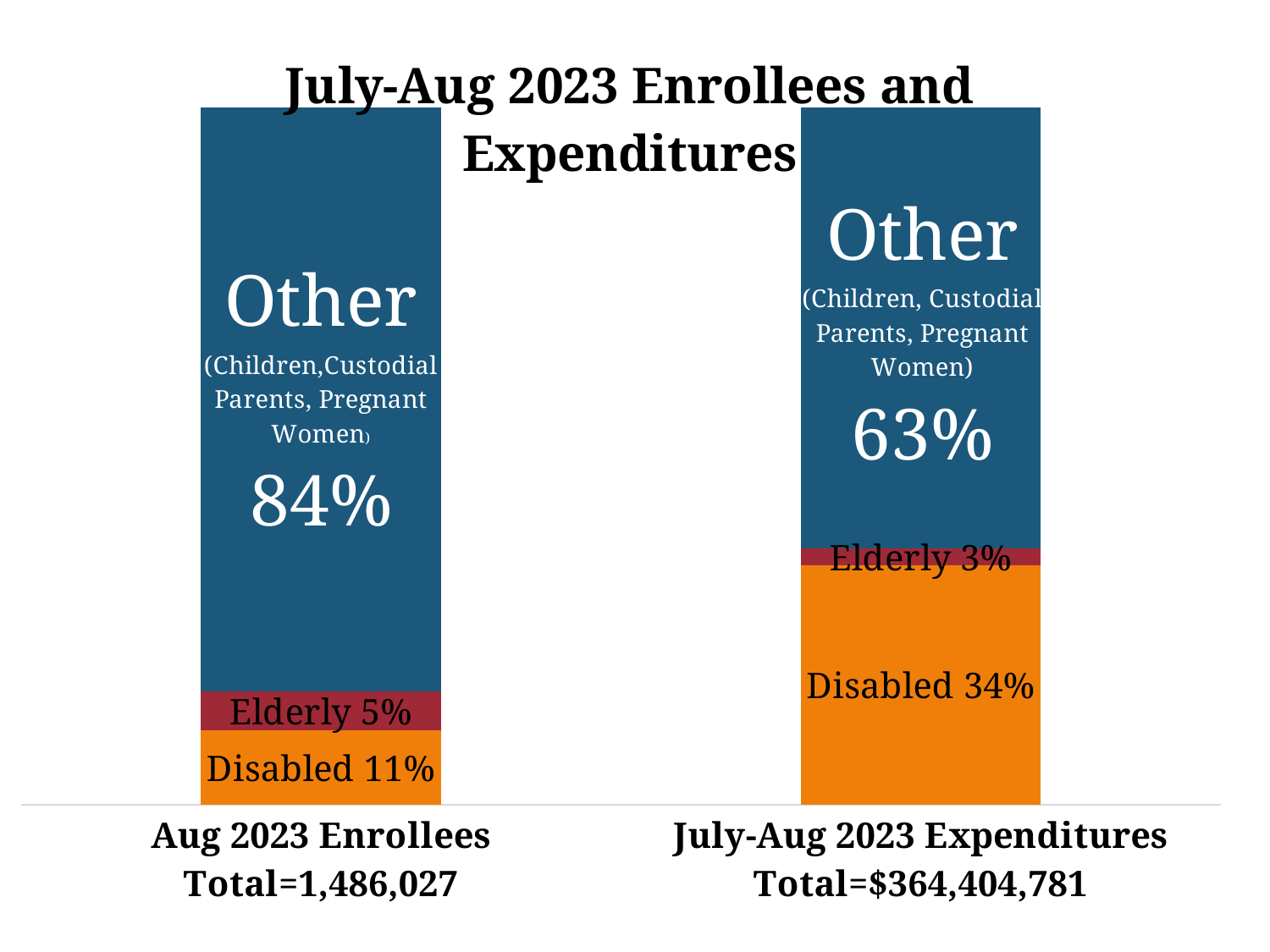
What kind of chart is shown on the slide? Stacked bar chart What is the difference between the Disabled share of July-Aug 2023 Expenditures and the Disabled share of Aug 2023 Enrollees? 23 percentage points Which group has the smallest share of July-Aug 2023 Expenditures? Elderly What share of July-Aug 2023 Expenditures is Disabled? 34% What share of Aug 2023 Enrollees is Elderly? 5% What share of Aug 2023 Enrollees is Disabled? 11% Is the Other share larger for Aug 2023 Enrollees or for July-Aug 2023 Expenditures? Aug 2023 Enrollees What is the chart's title? July-Aug 2023 Enrollees and Expenditures Which group has the largest share of Aug 2023 Enrollees? Other (Children, Custodial Parents, Pregnant Women) What share of July-Aug 2023 Expenditures is Other (Children, Custodial Parents, Pregnant Women)? 63% What is the total number of Aug 2023 Enrollees shown on the slide? 1,486,027 What is the total of July-Aug 2023 Expenditures shown on the slide? $364,404,781